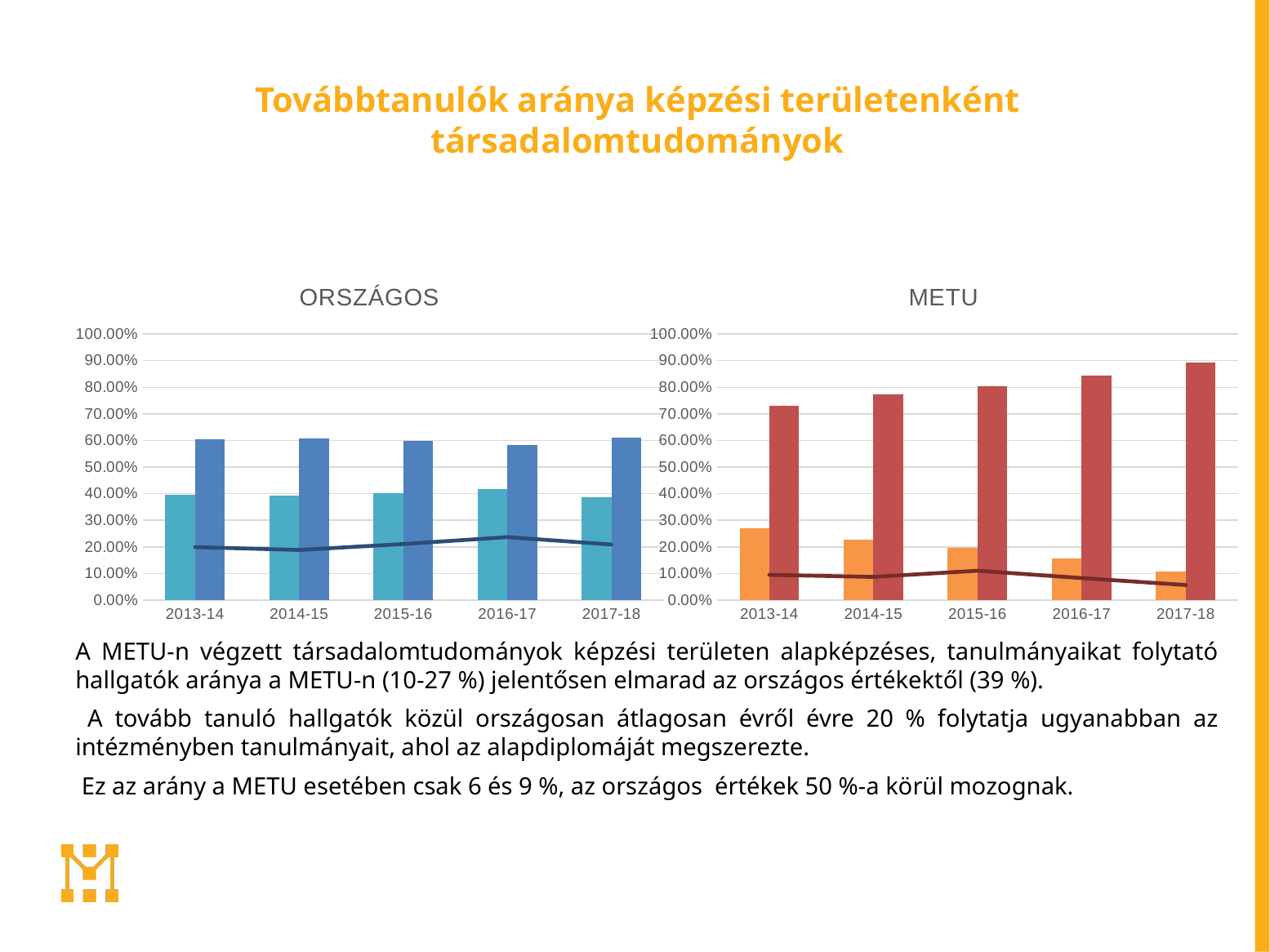
In the METU chart, do the red bars rise or fall from 2013-14 to 2017-18? rise In the ORSZÁGOS chart, is the dark blue bar for 2013-14 greater or less than 50.00%? greater In the METU chart, do the orange bars rise or fall from 2013-14 to 2017-18? fall How many academic years are shown on the x axis of the METU chart? 5 In the METU chart, which year has the tallest red bar? 2017-18 In the METU chart, is the red bar for 2017-18 greater or less than 80.00%? greater What are the titles of the two charts on the slide? ORSZÁGOS and METU In the METU chart, is the orange bar for 2017-18 greater or less than 20.00%? less In the METU chart, which year has the shortest orange bar? 2017-18 What kind of chart is the ORSZÁGOS chart? combination bar and line chart In the METU chart, which is larger: the red bar for 2013-14 or the red bar for 2017-18? 2017-18